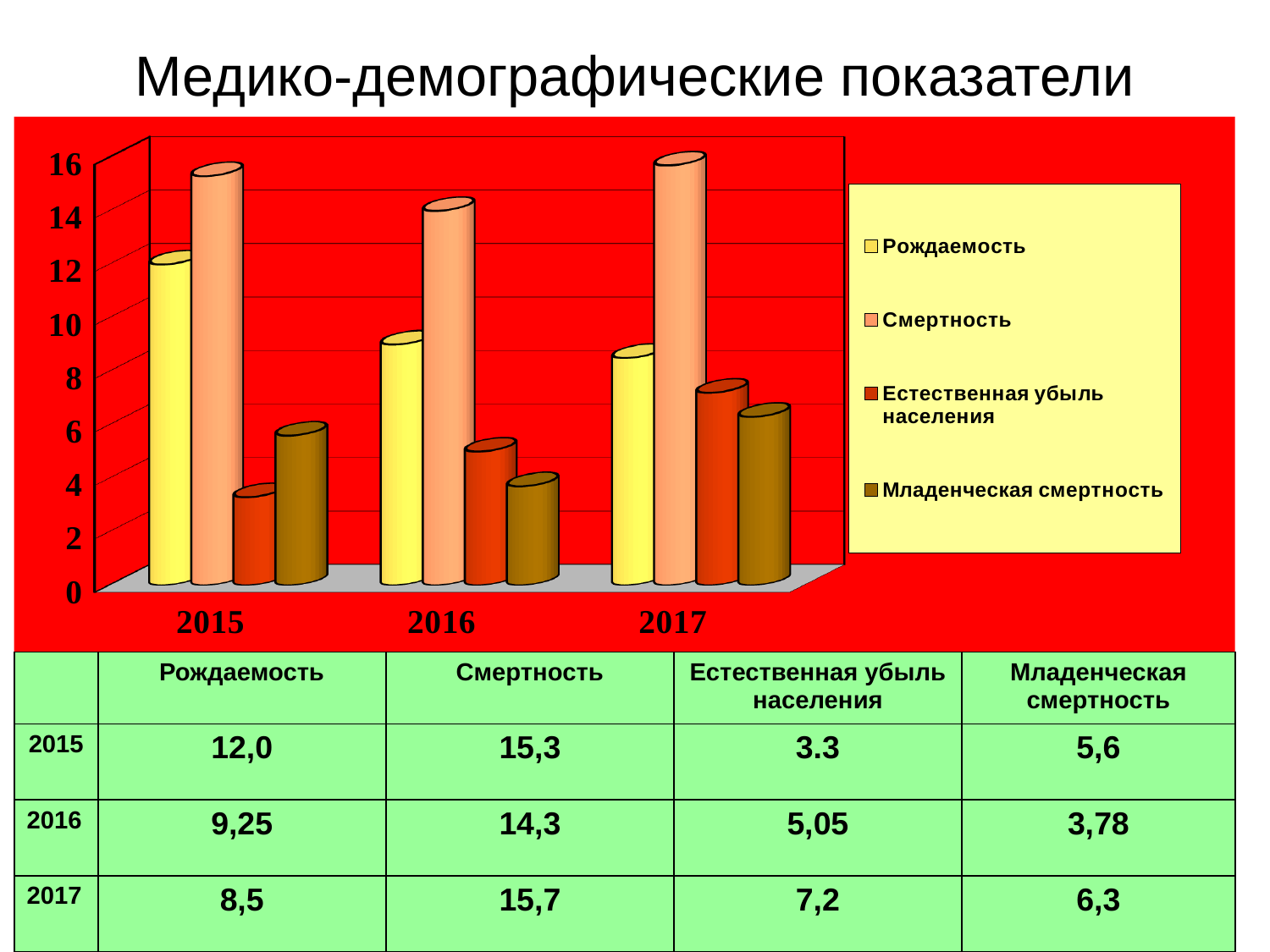
What is the value of Рождаемость for 2016? 9,25 What is the title of the slide? Медико-демографические показатели What is the value of Младенческая смертность for 2015? 5,6 In which year is Рождаемость lowest? 2017 In which year is Естественная убыль населения highest? 2017 What type of chart is shown on the slide? bar chart How many series does the chart legend list? 4 Which is larger in 2016: Смертность or Рождаемость? Смертность Is the value of Смертность for 2015 greater or less than 14? greater Does Рождаемость rise or fall from 2015 to 2017? fall How many years are shown on the x axis of the chart? 3 What is the value of Смертность for 2017? 15,7